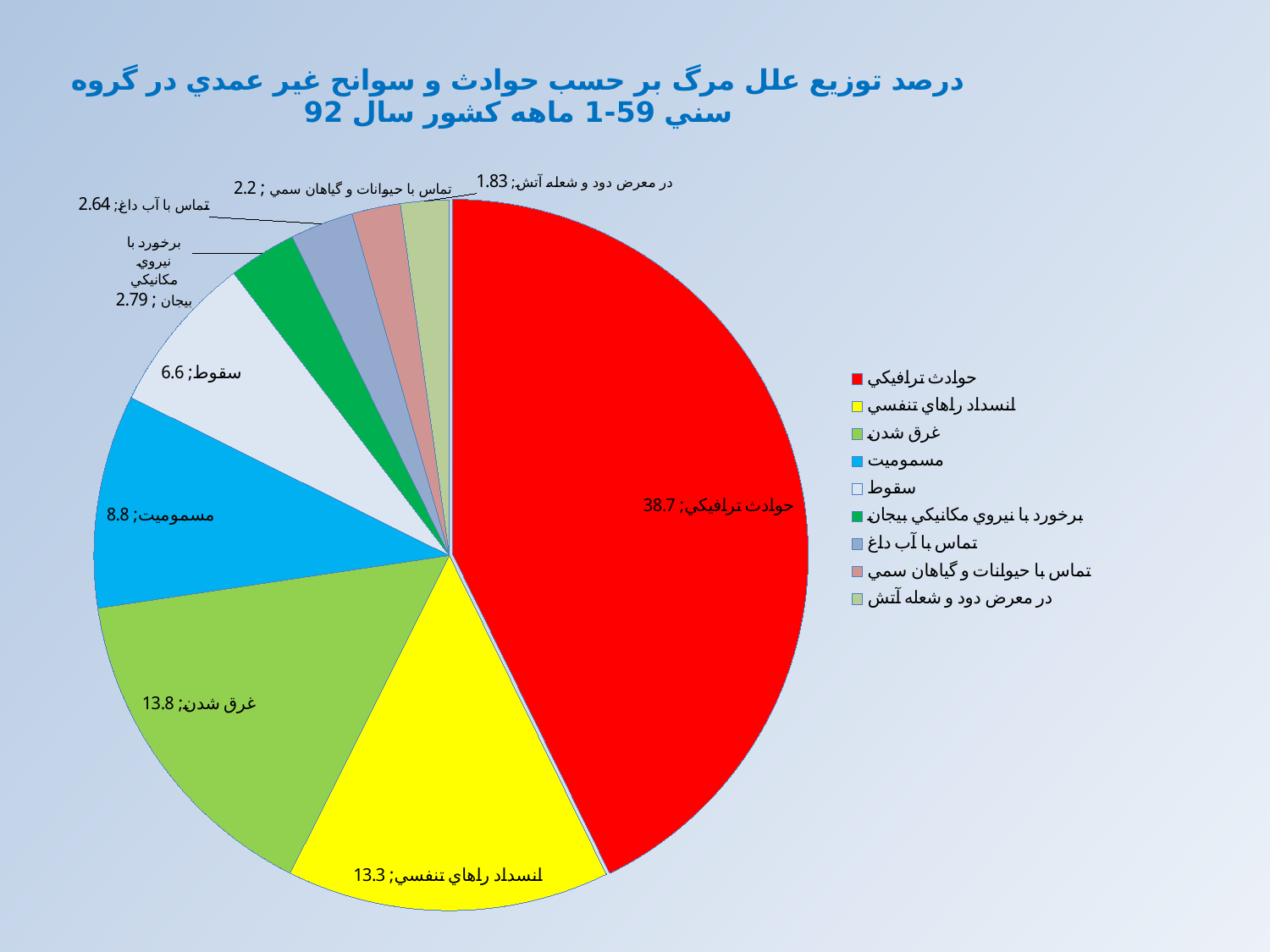
Which is larger, the value for مسموميت (poisoning) or the value for سقوط (falls)? مسموميت Which cause of death has the largest slice of the pie? حوادث ترافيكي Which cause of death has the smallest slice of the pie? در معرض دود و شعله آتش What is the difference between the values for حوادث ترافيكي (38.7) and غرق شدن (13.8)? 24.9 What is the value shown for انسداد راههاي تنفسي (airway obstruction)? 13.3 What is the value shown for در معرض دود و شعله آتش (exposure to smoke and fire)? 1.83 What colour is the slice for حوادث ترافيكي (traffic accidents)? red What is the value shown for غرق شدن (drowning)? 13.8 How many slices does the pie chart have? 9 What kind of chart is shown on the slide? pie chart What is the value shown for حوادث ترافيكي (traffic accidents)? 38.7 What is the value shown for سقوط (falls)? 6.6